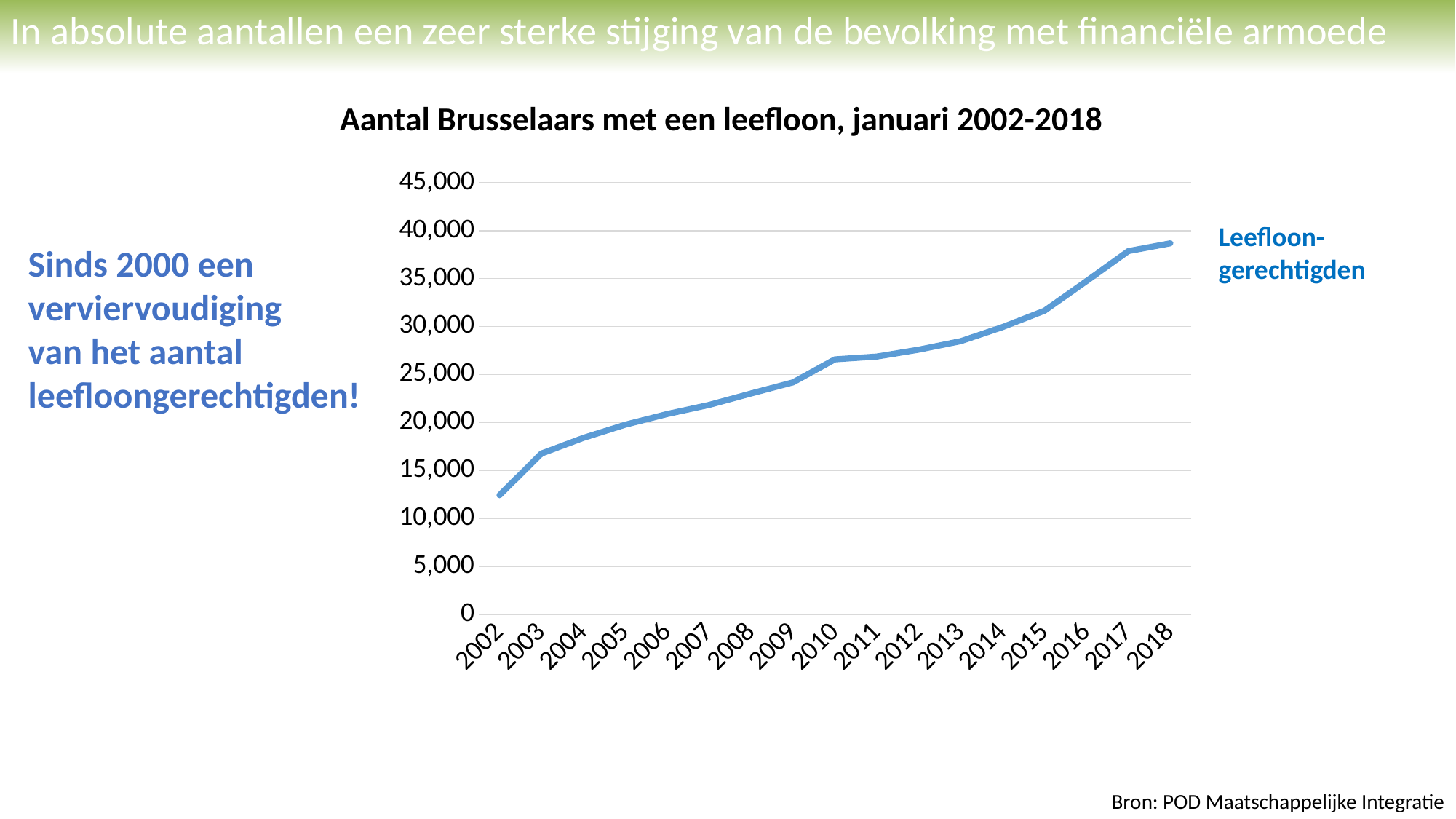
Do the values rise or fall from 2002 to 2018? Rise Which year has the larger value, 2005 or 2015? 2015 What kind of chart is shown on the slide? Line chart What is the name of the series plotted in the chart? Leefloon-gerechtigden Is the value for 2010 greater or less than 25,000? greater Which year has the highest value? 2018 How many years are plotted along the x axis? 17 What is the title of the chart? Aantal Brusselaars met een leefloon, januari 2002-2018 Is the value for 2018 greater or less than 35,000? greater Is the value for 2002 greater or less than 15,000? less Which year has the lowest value? 2002